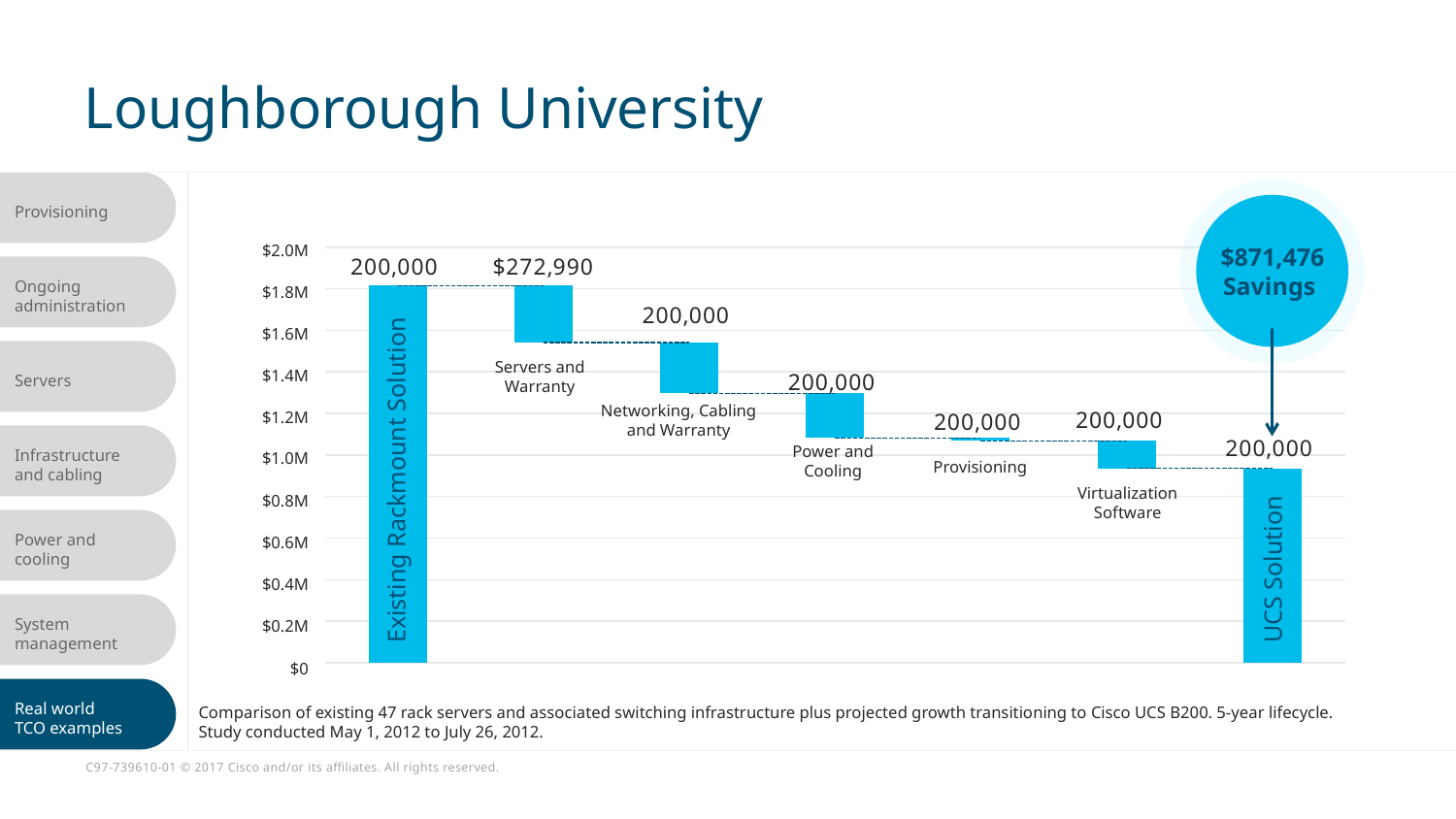
Is the top of the Existing Rackmount Solution bar greater or less than $1.6M? greater What kind of chart is shown on the slide? bar chart Does the running total rise or fall from Existing Rackmount Solution to UCS Solution across the chart? fall Which bar is taller, Existing Rackmount Solution or UCS Solution? Existing Rackmount Solution What is the highest value shown on the y axis of the chart? $2.0M Is the top of the Networking, Cabling and Warranty step greater or less than $1.2M? greater Is the top of the UCS Solution bar greater or less than $1.0M? less What data label is printed above the Servers and Warranty bar? $272,990 Which category has the tallest bar in the chart? Existing Rackmount Solution What savings amount is shown in the circle at the top right of the chart? $871,476 How many categories are shown along the x axis of the chart? 7 What is the label of the last bar on the right of the chart? UCS Solution